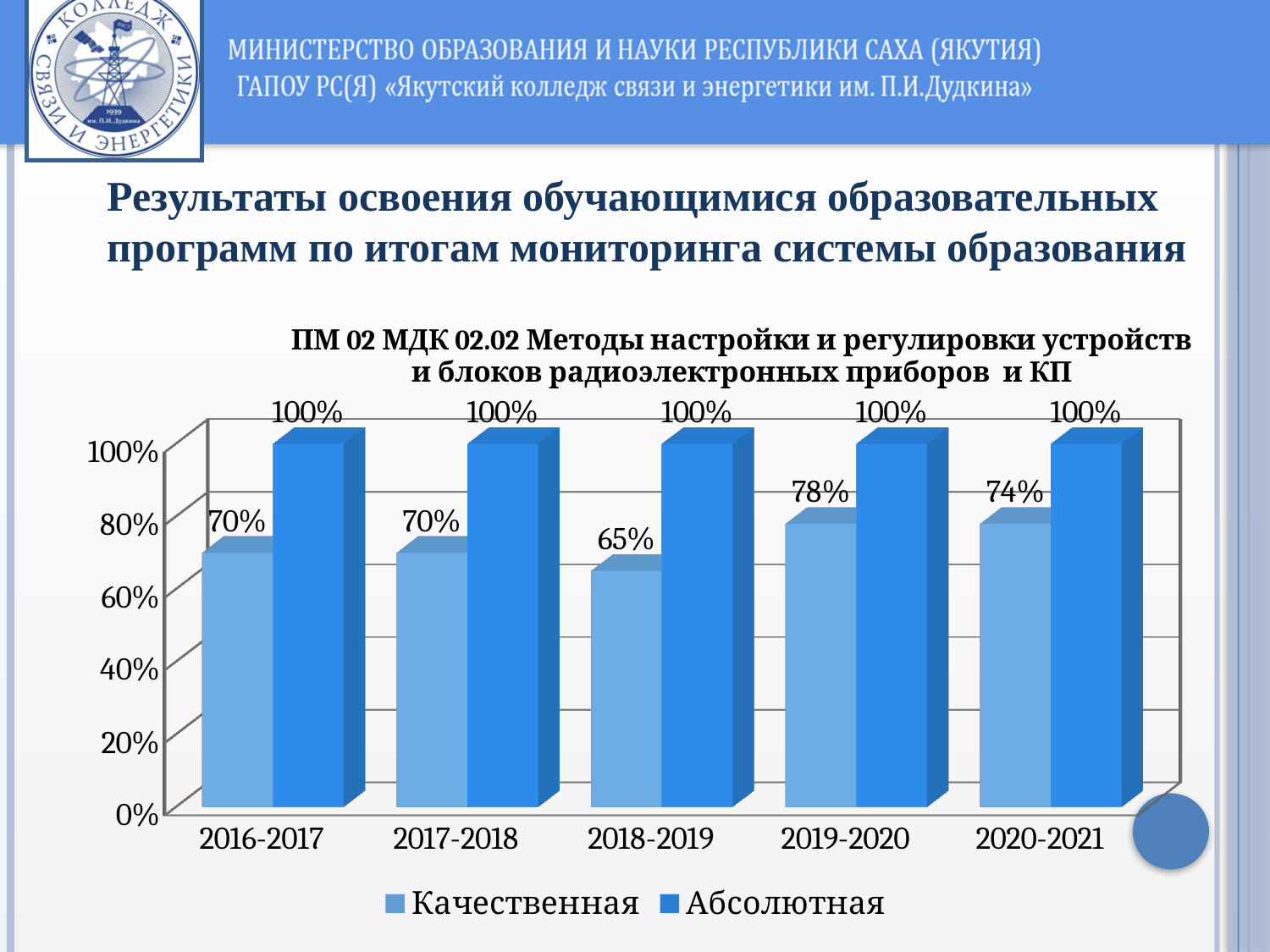
What is the value of Качественная for 2018-2019? 65% How many years are shown on the x axis? 5 Which year has the highest Качественная value? 2019-2020 What is the value of Абсолютная for 2020-2021? 100% What is the difference between the Качественная values for 2019-2020 and 2018-2019? 13% What is the difference between the Абсолютная and Качественная values for 2020-2021? 26% What is the value of Качественная for 2019-2020? 78% Which series is shown in the darker blue colour? Абсолютная Which is larger, the Качественная value for 2017-2018 or for 2020-2021? 2020-2021 Which year has the lowest Качественная value? 2018-2019 What kind of chart is shown on the slide? Bar chart How many series does the legend list? 2